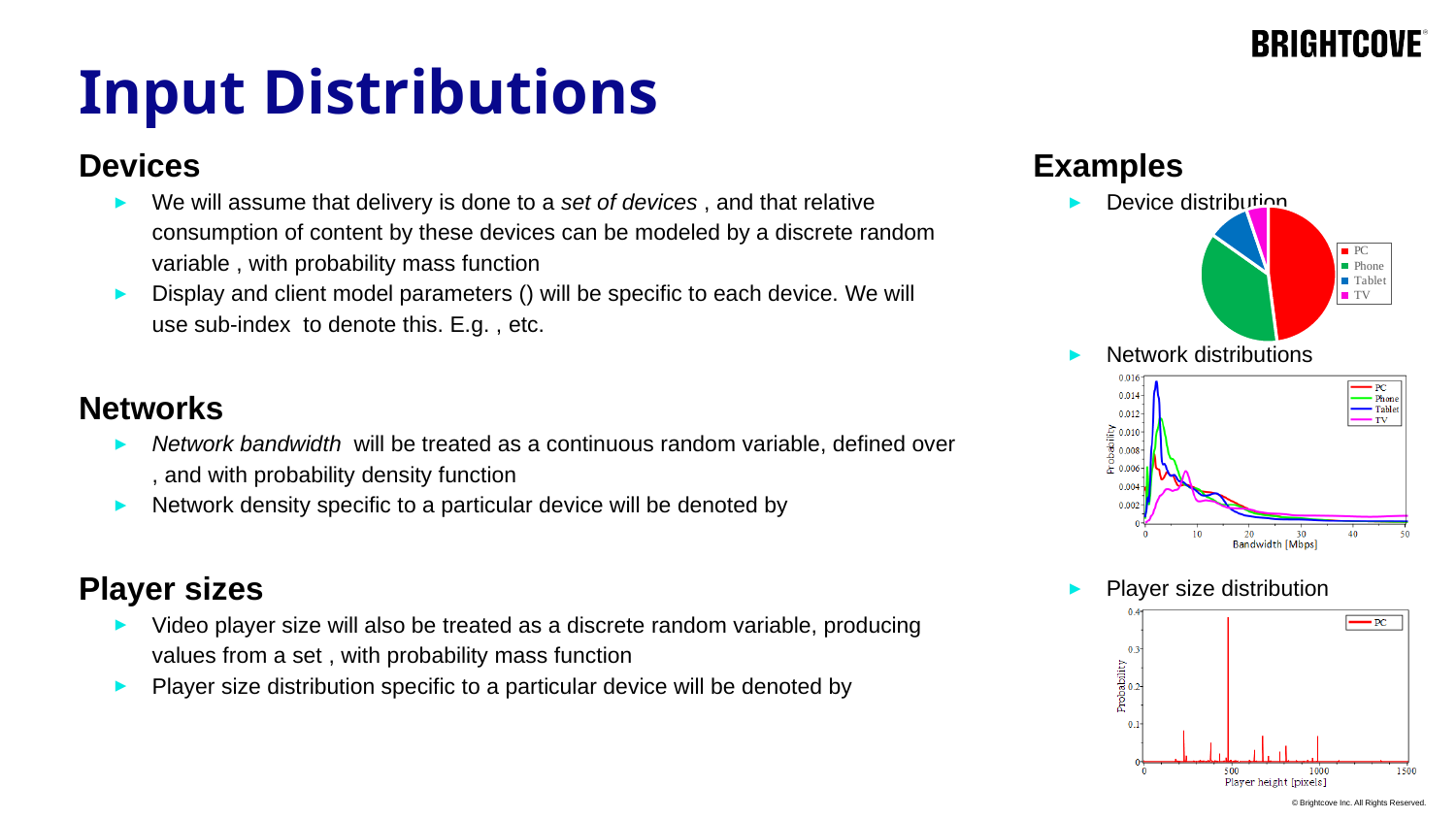
How many series does the legend of the Network distributions chart list? 4 In the Device distribution pie chart, which slice is larger, Phone or Tablet? Phone What kind of chart is the Network distributions chart? line chart How many series does the legend of the Player size distribution chart list? 1 In the Network distributions chart, is the peak value of the Tablet series greater or less than 0.012? greater How many devices does the legend of the Device distribution pie chart list? 4 In the Player size distribution chart, is the tallest spike greater or less than 0.3? greater In the Network distributions chart, what is the label of the x axis? Bandwidth [Mbps] In the Device distribution pie chart, which device has the largest slice? PC What kind of chart is the Device distribution chart? pie chart In the Network distributions chart, which series reaches the highest peak probability? Tablet In the Device distribution pie chart, which device has the smallest slice? TV